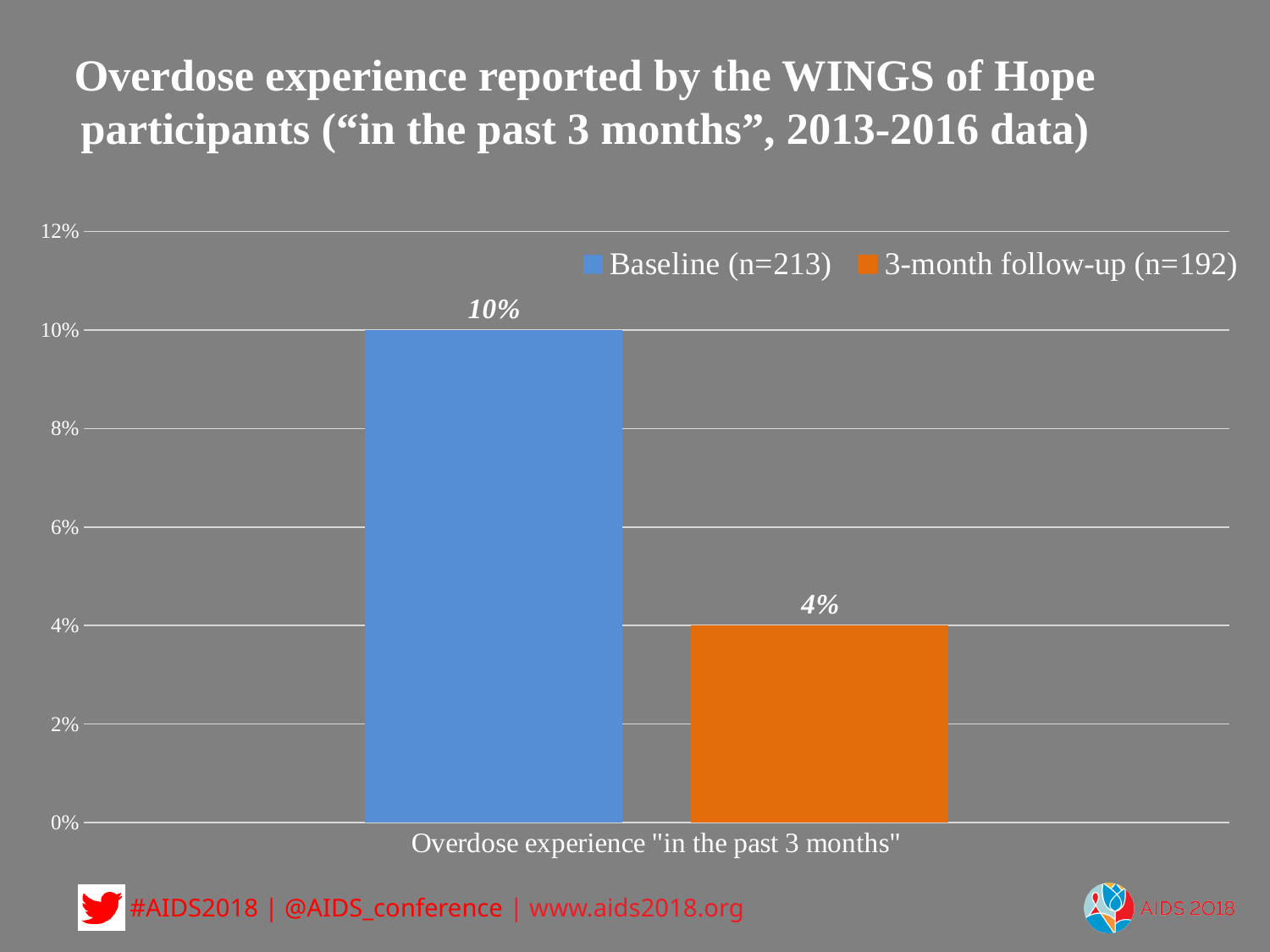
What kind of chart is shown on the slide? Bar chart What is the category label shown on the x axis? Overdose experience "in the past 3 months" How many series does the legend list? 2 What is the value for 3-month follow-up (n=192)? 4% Which series has the higher value, Baseline (n=213) or 3-month follow-up (n=192)? Baseline (n=213) What is the difference between the Baseline (n=213) value and the 3-month follow-up (n=192) value? 6% How many bars are plotted in the chart? 2 What colour is the bar for 3-month follow-up (n=192)? Orange Which series has the lowest value? 3-month follow-up (n=192) Is the value for 3-month follow-up (n=192) greater or less than 6%? less What is the value for Baseline (n=213)? 10% Is the value for Baseline (n=213) greater or less than 8%? greater